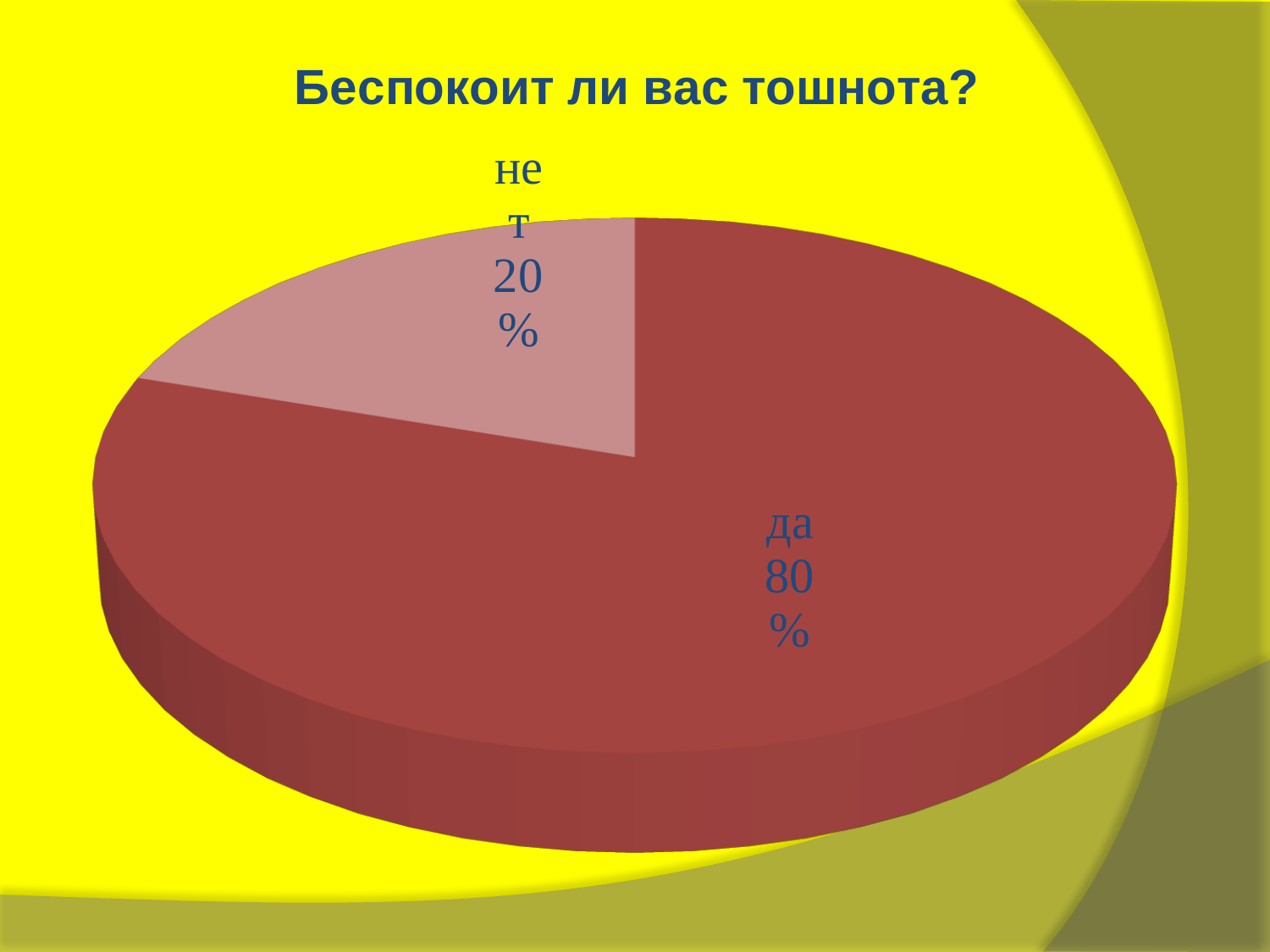
What share of the pie is labelled "нет"? 20% How many slices does the pie chart have? 2 Which slice is larger, "да" or "нет"? да Is the share for "да" greater or less than 50%? greater Which slice is the largest? да What share of the pie is labelled "да"? 80% Which slice is the smallest? нет What is the difference in percentage points between the "да" and "нет" slices? 60 What kind of chart is shown on the slide? pie chart Is the share for "нет" greater or less than 50%? less Which slice is shown in the lighter pink colour? нет What is the title of the chart? Беспокоит ли вас тошнота?